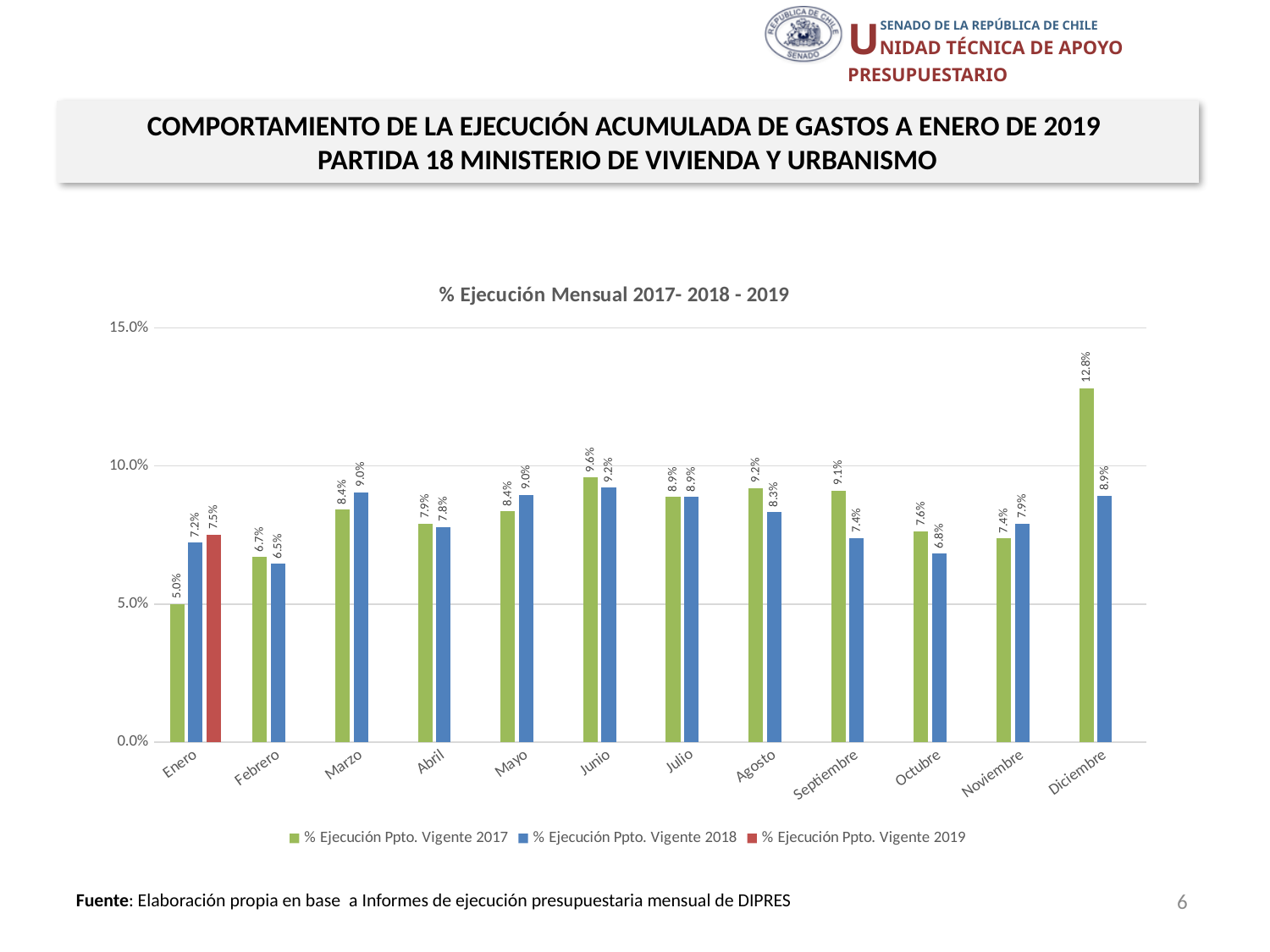
Which month has the highest value in the % Ejecución Ppto. Vigente 2017 series? Diciembre Is the value for Diciembre in the 2017 series greater or less than 10.0%? greater What is the difference between the 2017 and 2018 values for Septiembre? 1.7% What is the value for Diciembre in the % Ejecución Ppto. Vigente 2017 series? 12.8% Which month has the lowest value in the % Ejecución Ppto. Vigente 2017 series? Enero For Agosto, which series has the larger value: % Ejecución Ppto. Vigente 2017 or % Ejecución Ppto. Vigente 2018? % Ejecución Ppto. Vigente 2017 How many series does the legend list? 3 How many months are shown on the x axis? 12 What is the value for Septiembre in the % Ejecución Ppto. Vigente 2018 series? 7.4% What kind of chart is shown on the slide? Bar chart What is the title of the chart? % Ejecución Mensual 2017- 2018 - 2019 What is the value for Enero in the % Ejecución Ppto. Vigente 2019 series? 7.5%